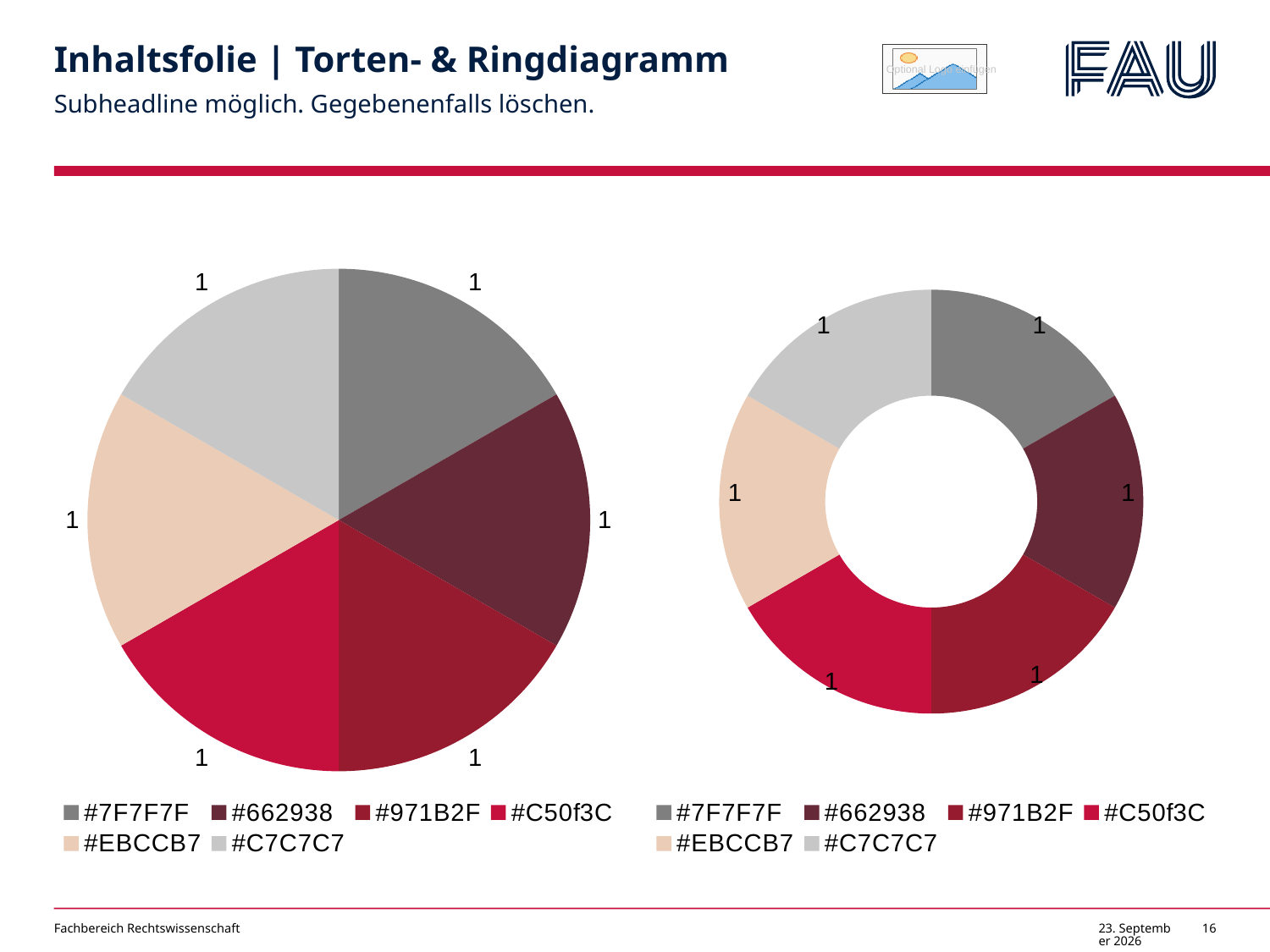
How many slices does the pie chart on the left have? 6 Which legend entry in the pie chart on the left is shown in the lightest beige colour? #EBCCB7 In the doughnut chart on the right, what is the value for #662938? 1 In the pie chart on the left, what is the value for #C50f3C? 1 How many entries does the legend of the pie chart on the left list? 6 In the doughnut chart on the right, what is the value for #EBCCB7? 1 How many segments does the doughnut chart on the right have? 6 What kind of chart is the chart on the left side of the slide? pie chart In the pie chart on the left, what is the difference between the value for #971B2F and the value for #C7C7C7? 0 In the doughnut chart on the right, what is the sum of all segment values? 6 What kind of chart is the chart on the right side of the slide? doughnut chart In the pie chart on the left, what is the value for #7F7F7F? 1